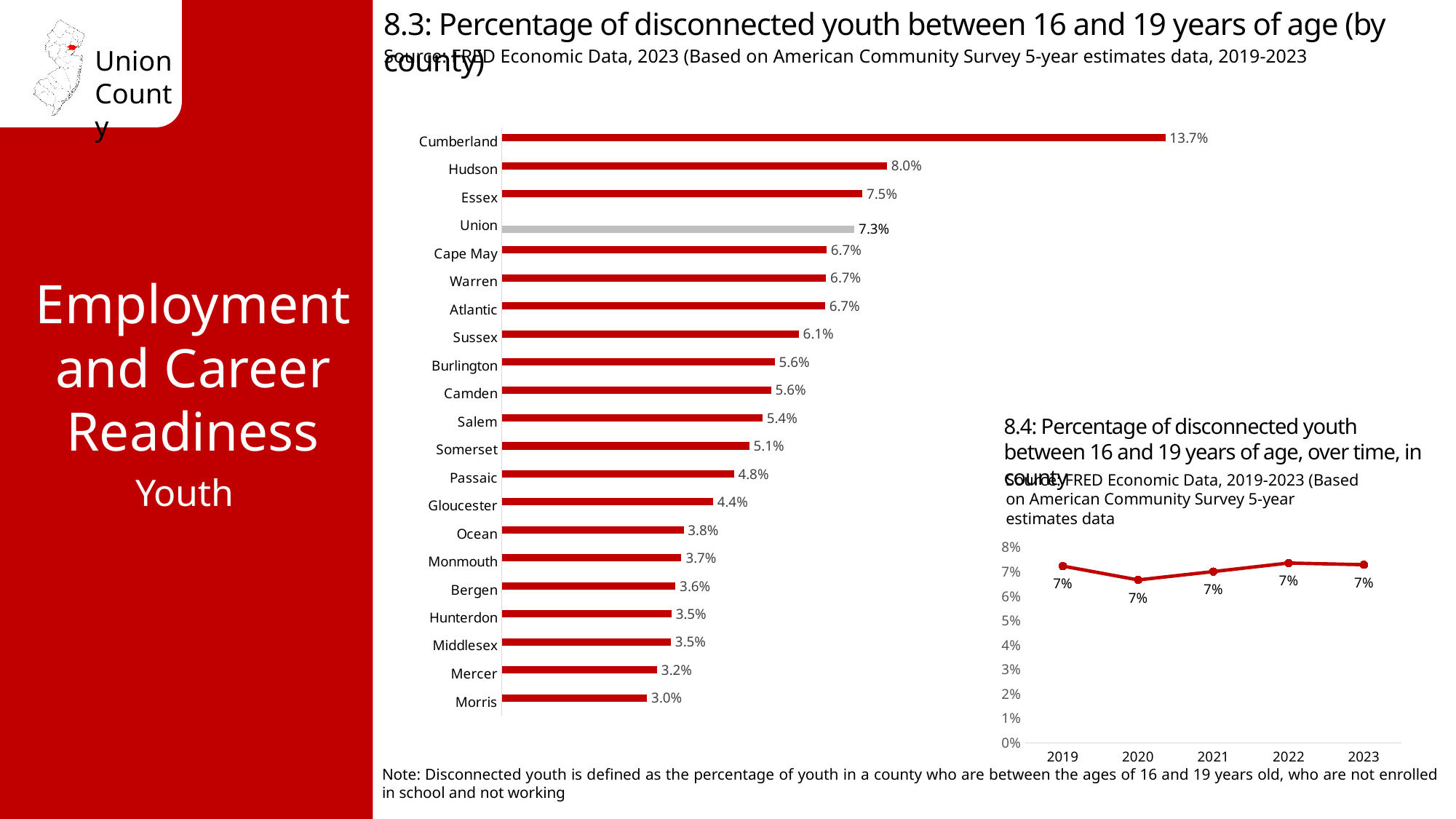
In chart 8.4 (percentage of disconnected youth over time in Union County), how many years are plotted? 5 In chart 8.3 (percentage of disconnected youth by county), what is the value for Hudson? 8.0% In chart 8.3 (percentage of disconnected youth by county), how many counties are shown? 21 In chart 8.3 (percentage of disconnected youth by county), what is the value for Union? 7.3% In chart 8.4 (percentage of disconnected youth over time in Union County), what is the value labelled for 2021? 7% What kind of chart is chart 8.3 (percentage of disconnected youth by county)? Bar chart In chart 8.3 (percentage of disconnected youth by county), what is the value for Gloucester? 4.4% In chart 8.3 (percentage of disconnected youth by county), which county has the lowest value? Morris In chart 8.3 (percentage of disconnected youth by county), which is larger, the value for Essex or the value for Sussex? Essex In chart 8.3 (percentage of disconnected youth by county), which county has the highest value? Cumberland What kind of chart is chart 8.4 (percentage of disconnected youth over time in Union County)? Line chart In chart 8.3 (percentage of disconnected youth by county), what is the difference between Cumberland and Hudson? 5.7%